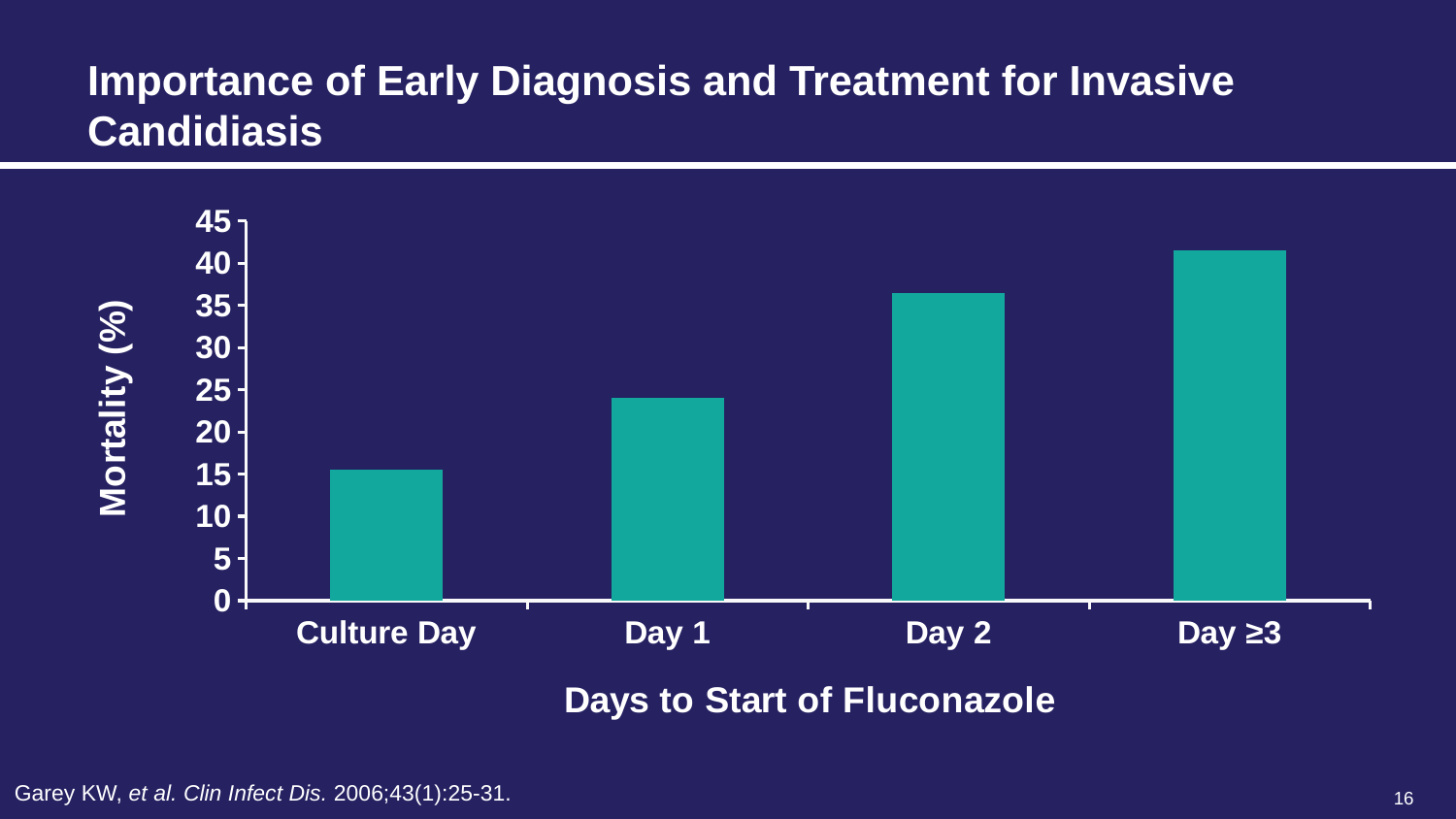
Is the mortality for Day 2 greater or less than 40? less What is the label of the y axis? Mortality (%) Is the mortality for Day 1 greater or less than 20? greater What kind of chart is shown on the slide? bar chart Is the mortality for Day 2 greater or less than 30? greater Does mortality rise or fall as days to start of fluconazole increase along the x axis? rise How many categories are shown on the x axis of the chart? 4 Which category has the lowest mortality? Culture Day Which has higher mortality, Day 1 or Day 2? Day 2 Which category has the highest mortality? Day ≥3